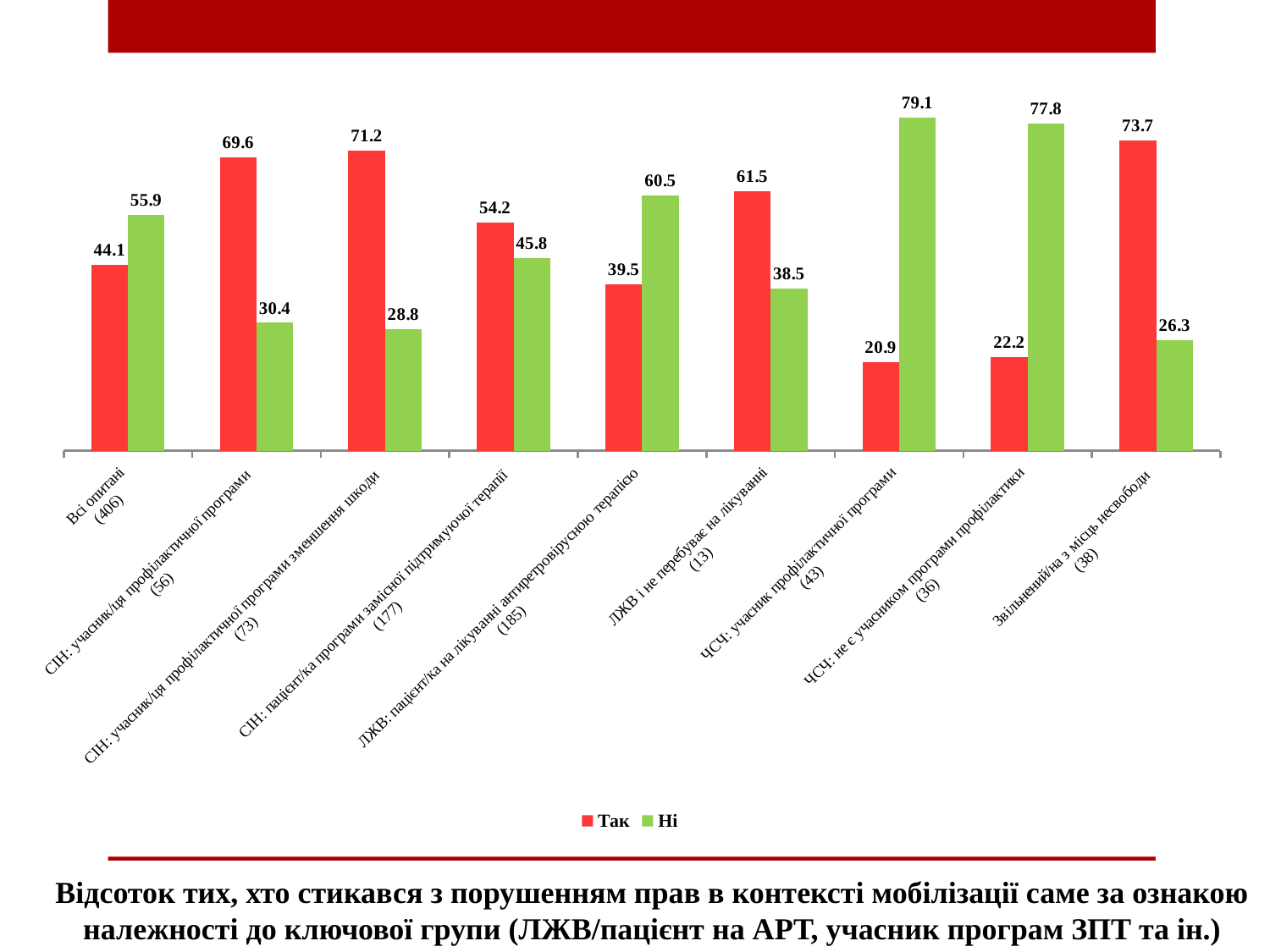
Which category has the lowest value for "Ні"? Звільнений/на з місць несвободи (38) How many series does the legend list? 2 How many categories are shown on the x axis? 9 What is the value of "Ні" for "ЧСЧ: учасник профілактичної програми (43)"? 79.1 What is the value of "Так" for "Звільнений/на з місць несвободи (38)"? 73.7 Which category has the lowest value for "Так"? ЧСЧ: учасник профілактичної програми (43) What kind of chart is shown on the slide? bar chart What is the difference between "Так" and "Ні" for "СІН: учасник/ця профілактичної програми (56)"? 39.2 Which colour represents the "Ні" series in the legend? green For "ЛЖВ: пацієнт/ка на лікуванні антиретровірусною терапією (185)", which is larger, "Так" or "Ні"? Ні What is the value of "Так" for "Всі опитані (406)"? 44.1 Which category has the highest value for "Так"? Звільнений/на з місць несвободи (38)